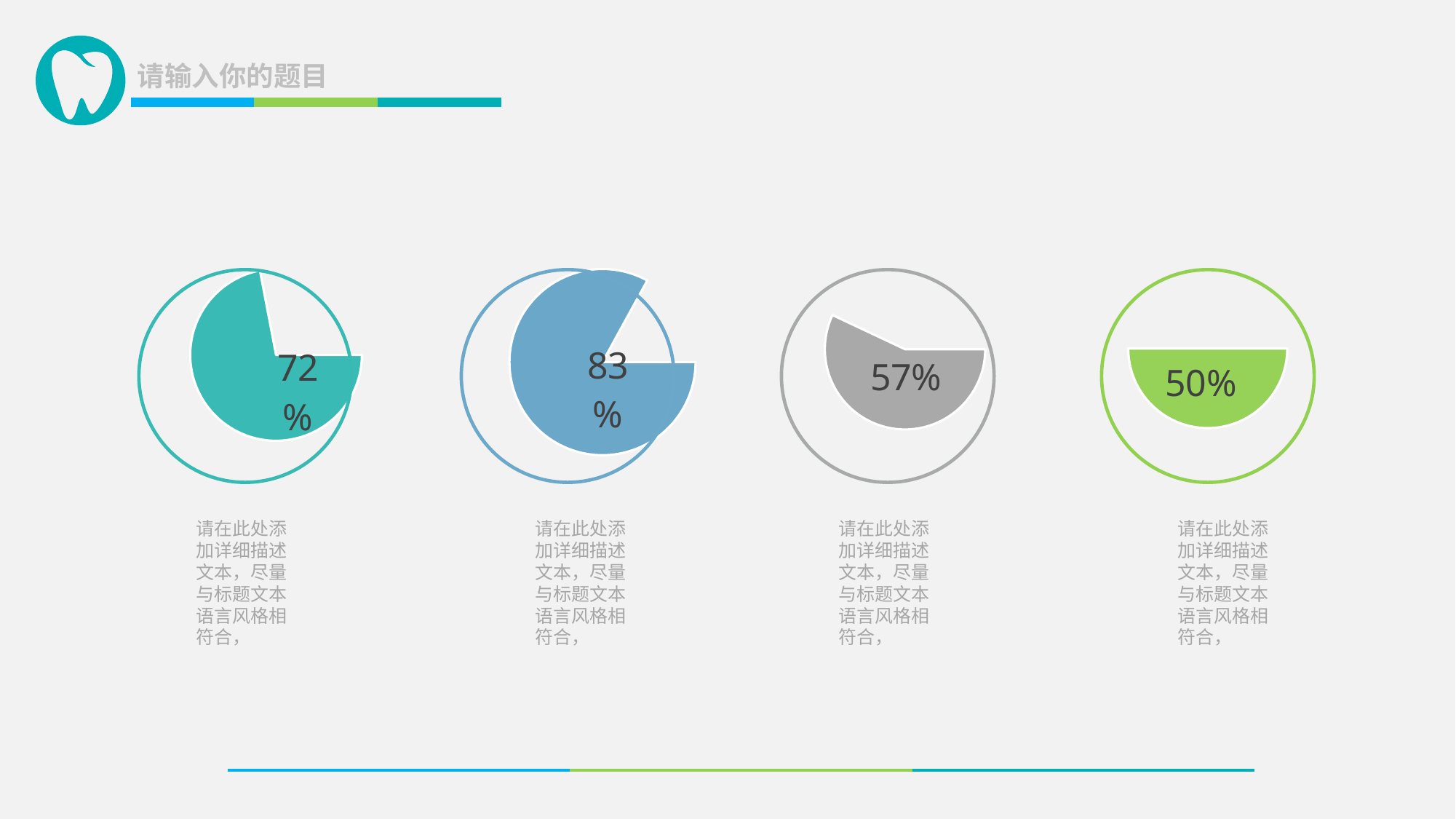
What value is shown on the third chart from the left (grey)? 57% How many charts are shown on the slide? 4 What value is shown on the leftmost (teal) chart? 72% What is the difference between the value on the third chart (57%) and the value on the rightmost chart (50%)? 7% What value is shown on the rightmost (green) chart? 50% What value is shown on the second chart from the left (blue)? 83% Which is larger, the value on the leftmost chart or the value on the third chart? The leftmost chart (72%) Which of the four charts shows the highest percentage? The second chart from the left (blue), 83% Which of the four charts shows the lowest percentage? The rightmost chart (green), 50% What is the difference between the value on the second chart (83%) and the value on the leftmost chart (72%)? 11% What colour is the filled portion of the rightmost chart? Green What kind of chart is used for each of the four figures on the slide? Pie chart